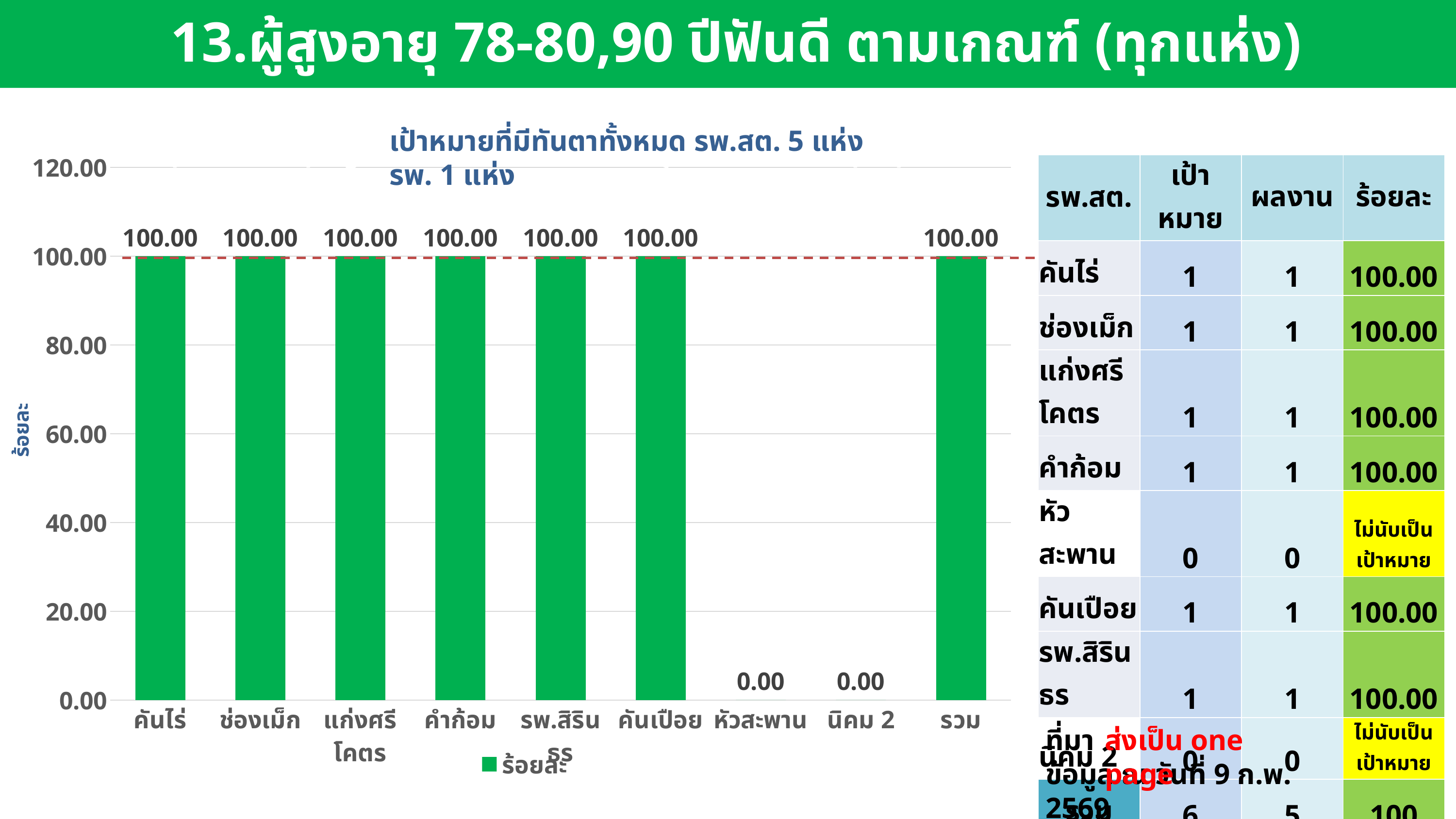
What is the value for หัวสะพาน in the bar chart? 0.00 What kind of chart is shown on the slide? bar chart What is the value for นิคม 2 in the bar chart? 0.00 What is the label of the y axis of the bar chart? ร้อยละ What is the value for คันเปือย in the bar chart? 100.00 What is the value for คันไร่ in the bar chart? 100.00 How many categories are shown on the x axis of the bar chart? 9 What is the legend entry of the bar chart? ร้อยละ What is the difference between the values for ช่องเม็ก and นิคม 2? 100.00 How many series does the legend of the bar chart list? 1 What is the value for รวม in the bar chart? 100.00 Which category has the lowest value in the bar chart, หัวสะพาน or คำก้อม? หัวสะพาน